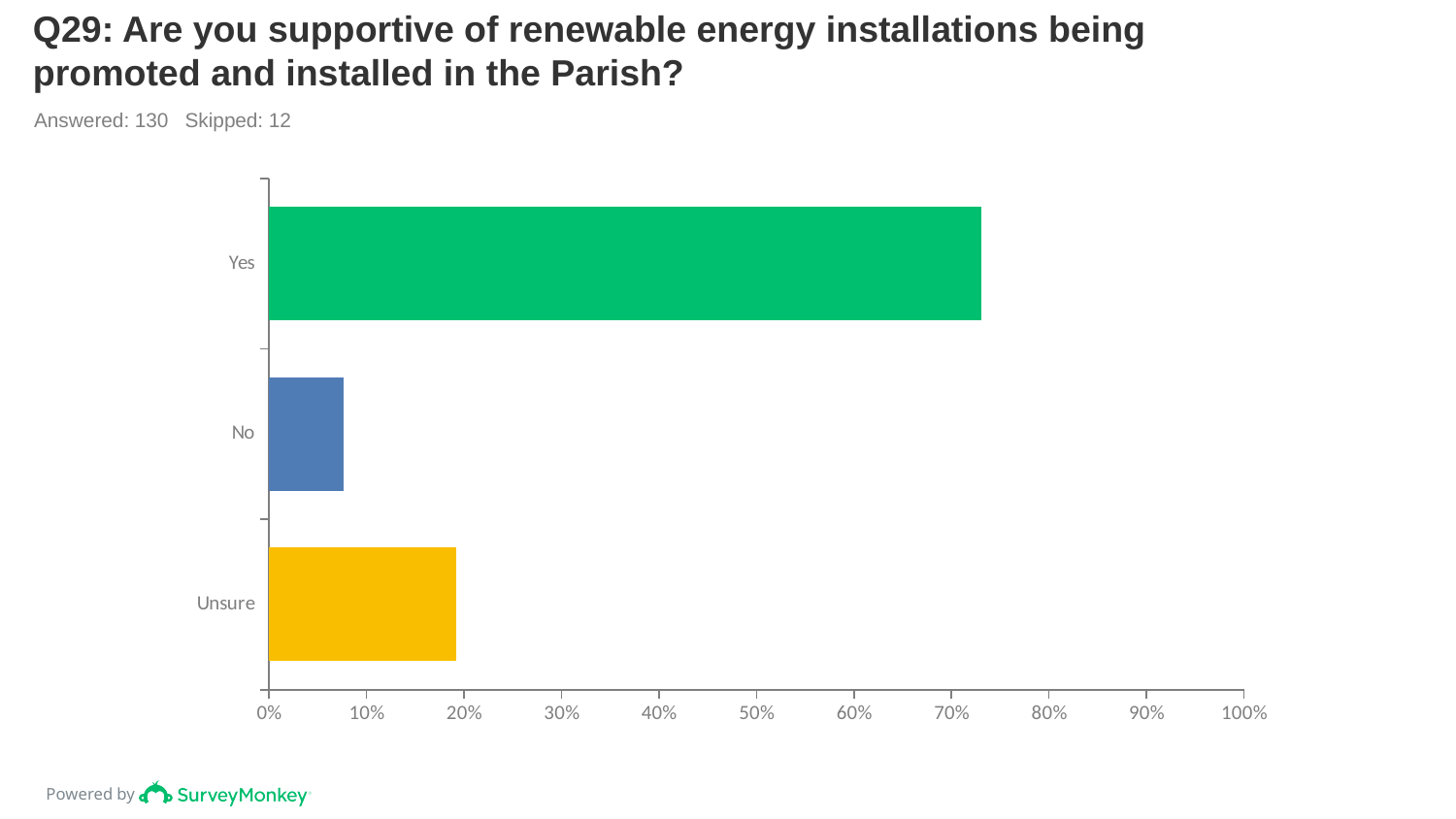
How many respondents answered this question according to the slide? 130 Is the value for Yes greater or less than 70%? greater What colour is the bar for Yes? green Which category has the highest value? Yes Is the value for No greater or less than 10%? less Is the value for Unsure greater or less than 10%? greater Which is larger, the value for Unsure or the value for No? Unsure How many categories are plotted in the chart? 3 Which is larger, the value for Yes or the value for Unsure? Yes Which category has the lowest value? No What kind of chart is shown on the slide? bar chart